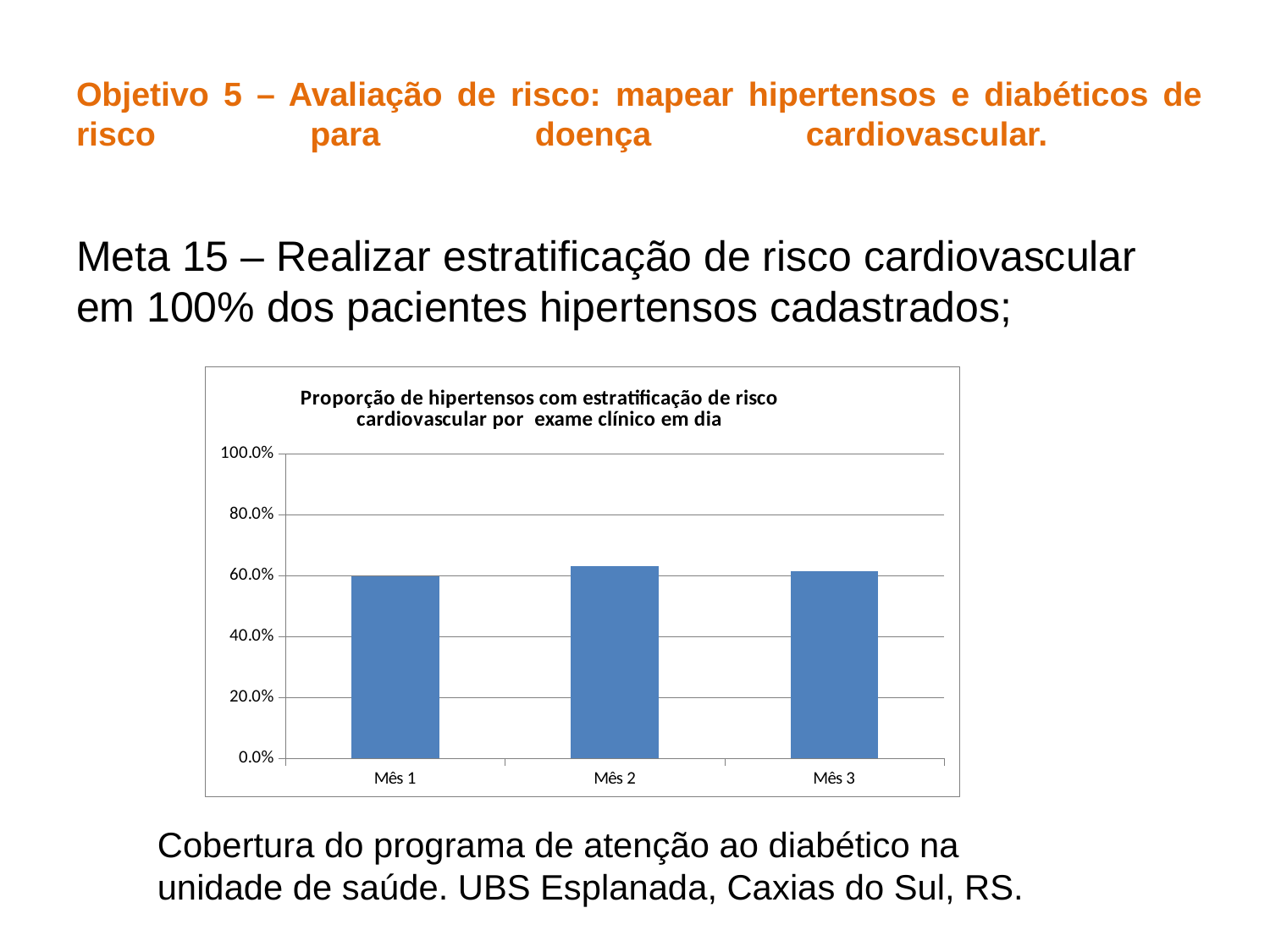
What is the label of the first category on the x axis? Mês 1 Which month has the highest bar in the chart? Mês 2 Is the value for Mês 2 greater or less than 80.0%? less What is the title of the chart? Proporção de hipertensos com estratificação de risco cardiovascular por exame clínico em dia How many categories are plotted on the x axis of the chart? 3 What kind of chart is shown on the slide? bar chart Is the value for Mês 2 greater or less than 60.0%? greater Is the value for Mês 1 greater or less than 80.0%? less What is the highest value shown on the y axis of the chart? 100.0% Which is larger, the value for Mês 1 or the value for Mês 2? Mês 2